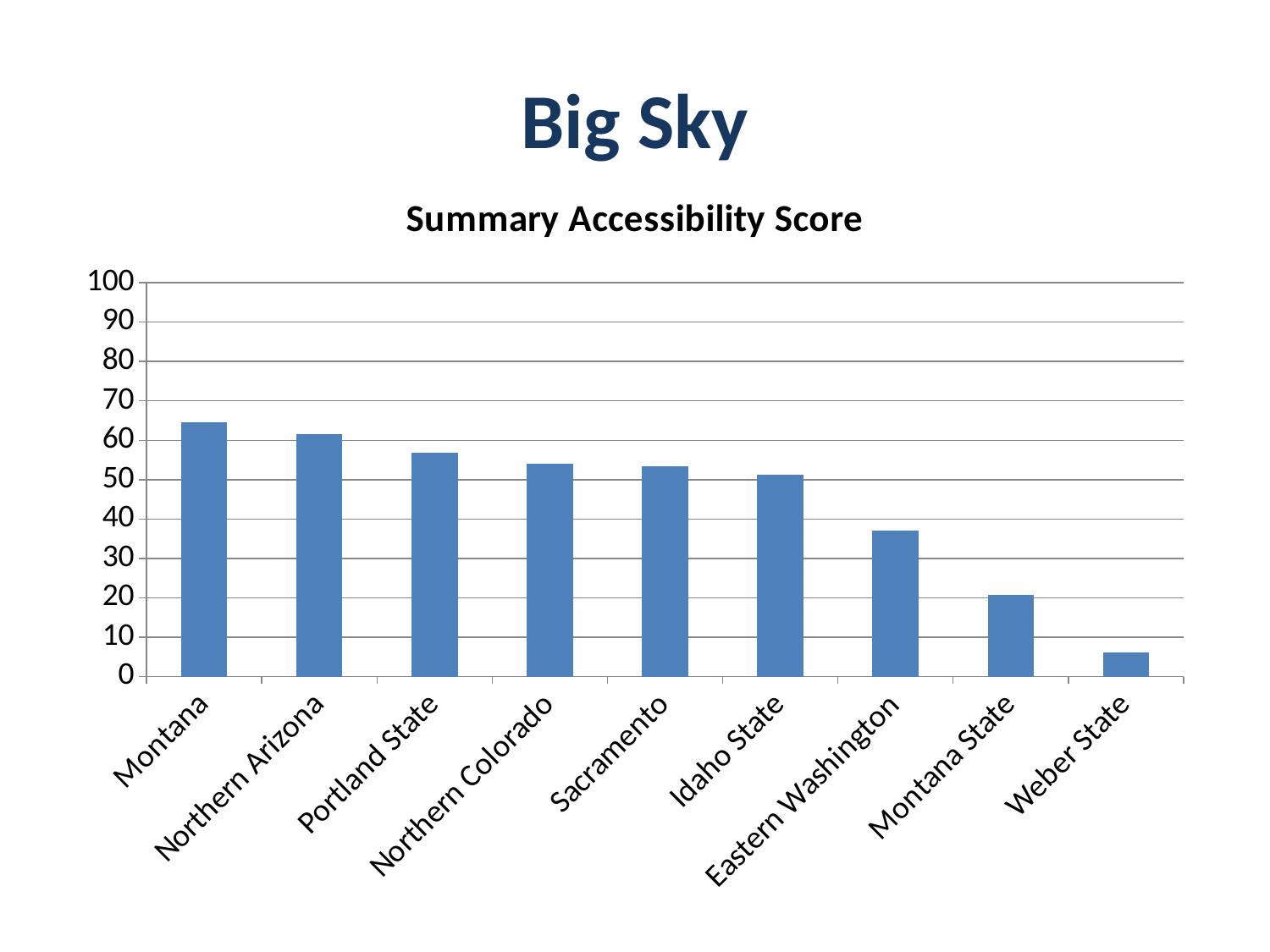
Which category has the lowest Summary Accessibility Score? Weber State Is the value for Weber State greater or less than 10? less Is the value for Eastern Washington greater or less than 40? less How many categories are plotted in the chart? 9 Do the values rise or fall moving from left to right along the x axis? fall Which has a higher value, Portland State or Eastern Washington? Portland State What kind of chart is shown on the slide? bar chart Is the value for Montana greater or less than 60? greater What is the title of the chart? Summary Accessibility Score Which has a higher value, Montana State or Idaho State? Idaho State Which category has the highest Summary Accessibility Score? Montana